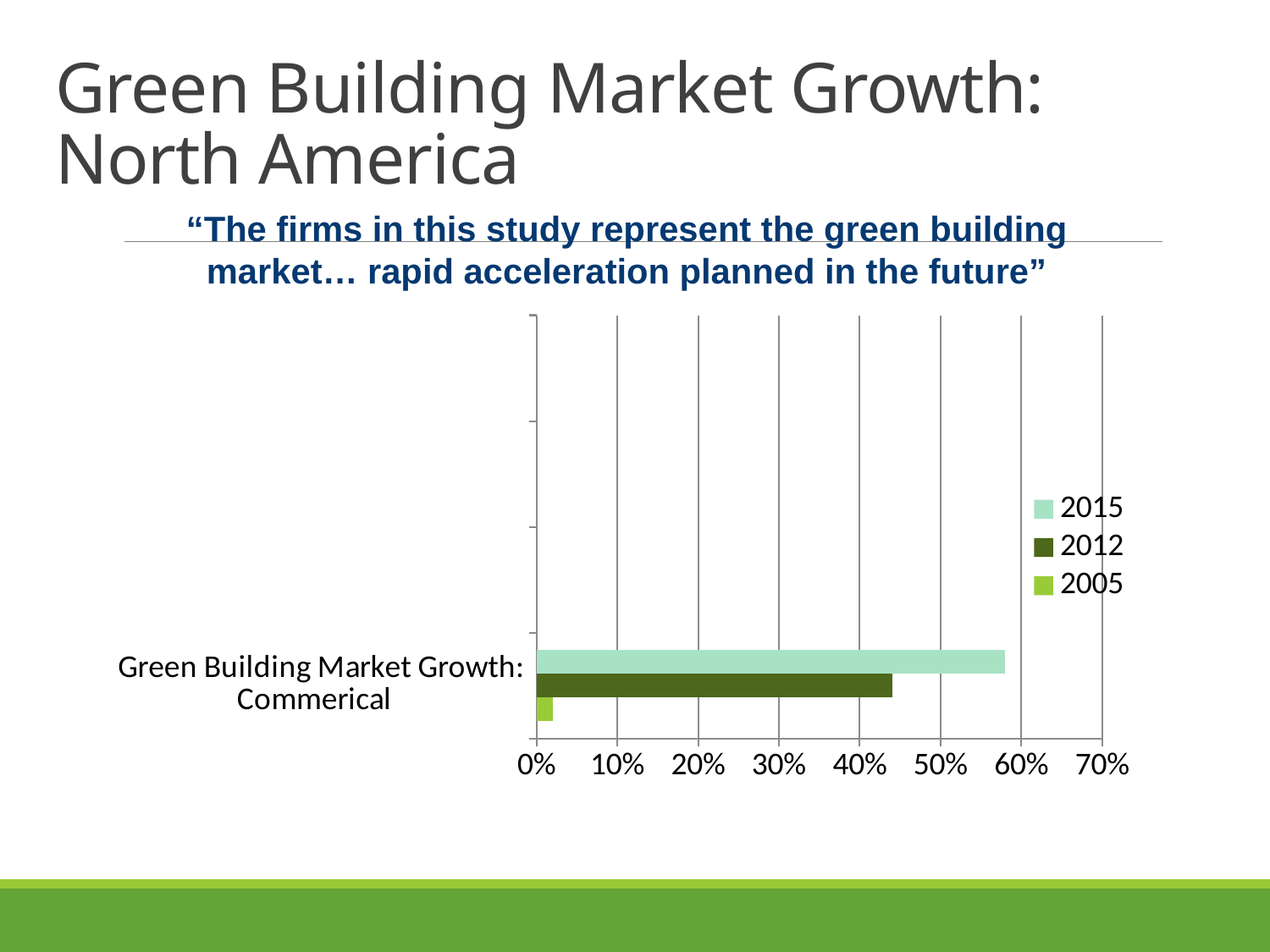
Which series has the highest value for Green Building Market Growth: Commerical? 2015 Which series is shown in the lightest colour in the legend? 2015 Is the value for 2005 greater or less than 10%? less Is the value for 2012 greater or less than 50%? less Which is larger, the value for 2012 or the value for 2005? 2012 How many series does the chart legend list? 3 Which series has the lowest value for Green Building Market Growth: Commerical? 2005 Is the value for 2015 greater or less than 60%? less What kind of chart is shown on the slide? bar chart How many categories are plotted on the chart? 1 What is the label of the category plotted on the chart? Green Building Market Growth: Commerical